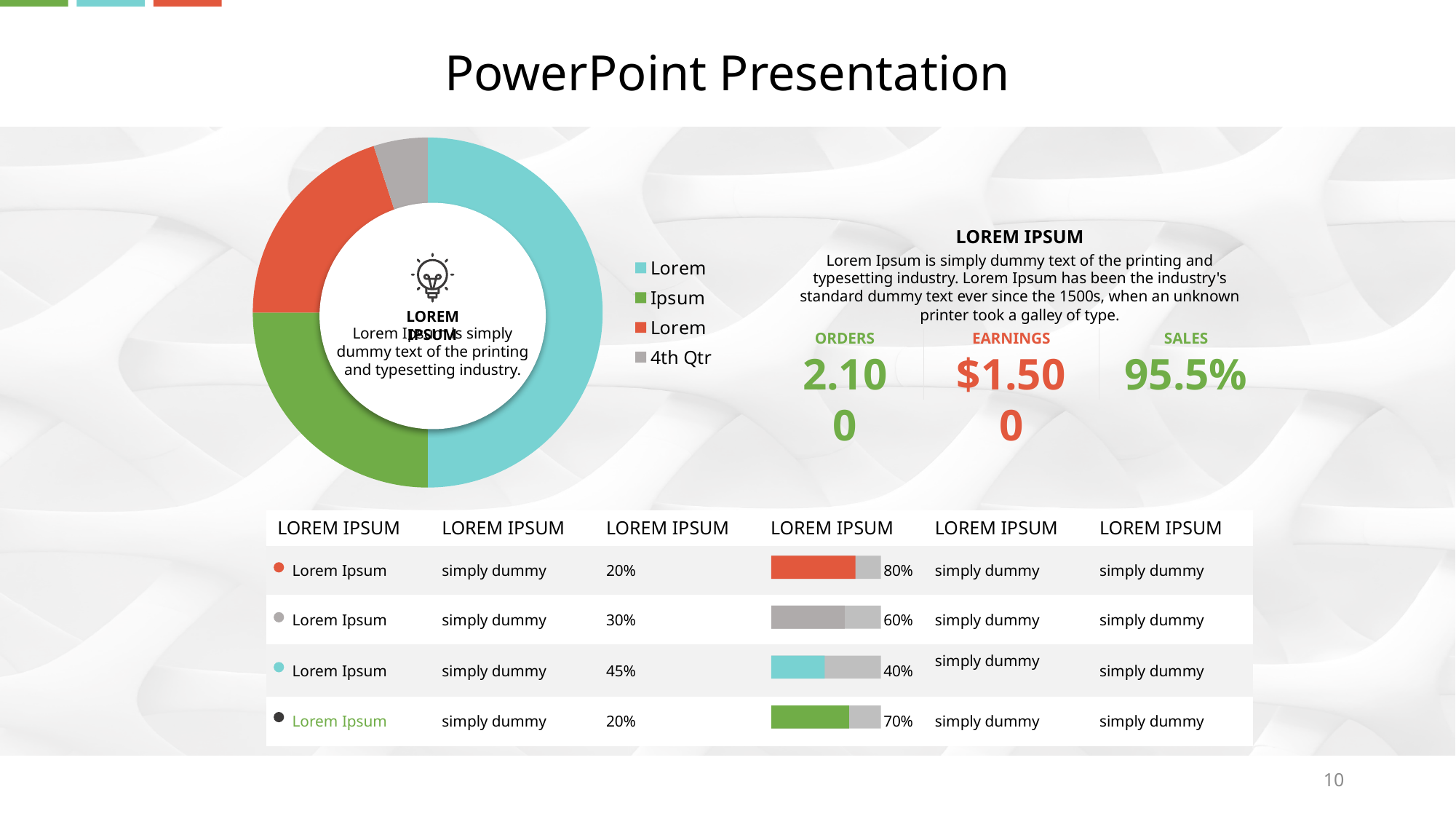
Which legend entry corresponds to the largest slice of the doughnut chart? Lorem Which slice is larger in the doughnut chart, Ipsum or 4th Qtr? Ipsum What is the last entry listed in the doughnut chart's legend? 4th Qtr What colour is the Ipsum slice in the doughnut chart? Green Which legend entry corresponds to the smallest slice of the doughnut chart? 4th Qtr What colour is the 4th Qtr slice in the doughnut chart? Grey How many entries does the legend of the doughnut chart list? 4 How many slices does the doughnut chart have? 4 What kind of chart is shown on the left of the slide? Doughnut (pie) chart